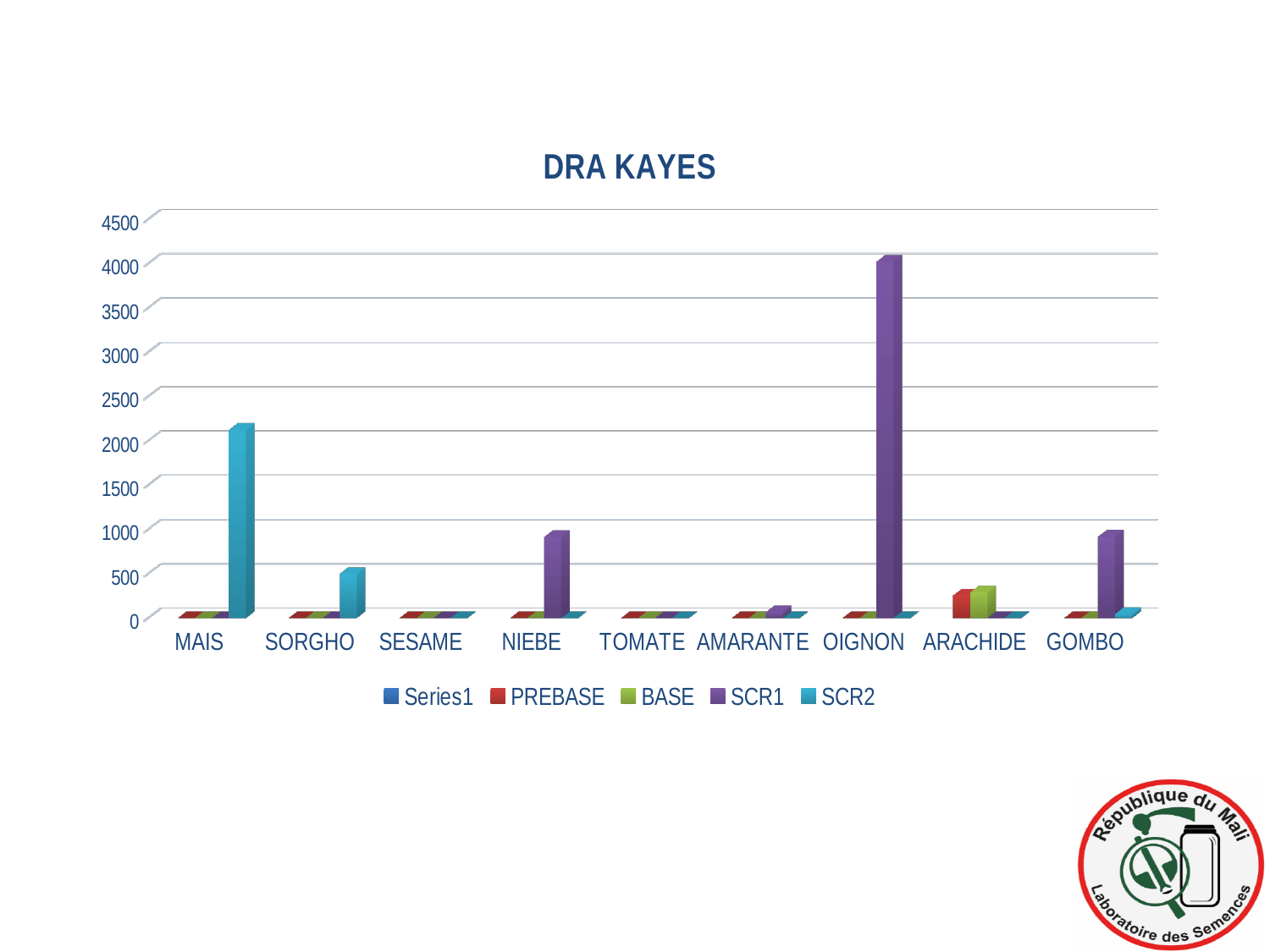
Is the SCR2 value for MAIS greater or less than 1500? greater What is the title of the chart? DRA KAYES Which has the larger SCR2 value, MAIS or SORGHO? MAIS How many categories are shown on the x axis of the chart? 9 Is the SCR1 value for NIEBE greater or less than 1000? less Which category has the tallest bar in the chart? OIGNON Is the SCR2 value for SORGHO greater or less than 1000? less Which has the larger SCR1 value, OIGNON or GOMBO? OIGNON How many series does the legend list? 5 What kind of chart is shown on the slide? bar chart Which series is shown in purple in the legend? SCR1